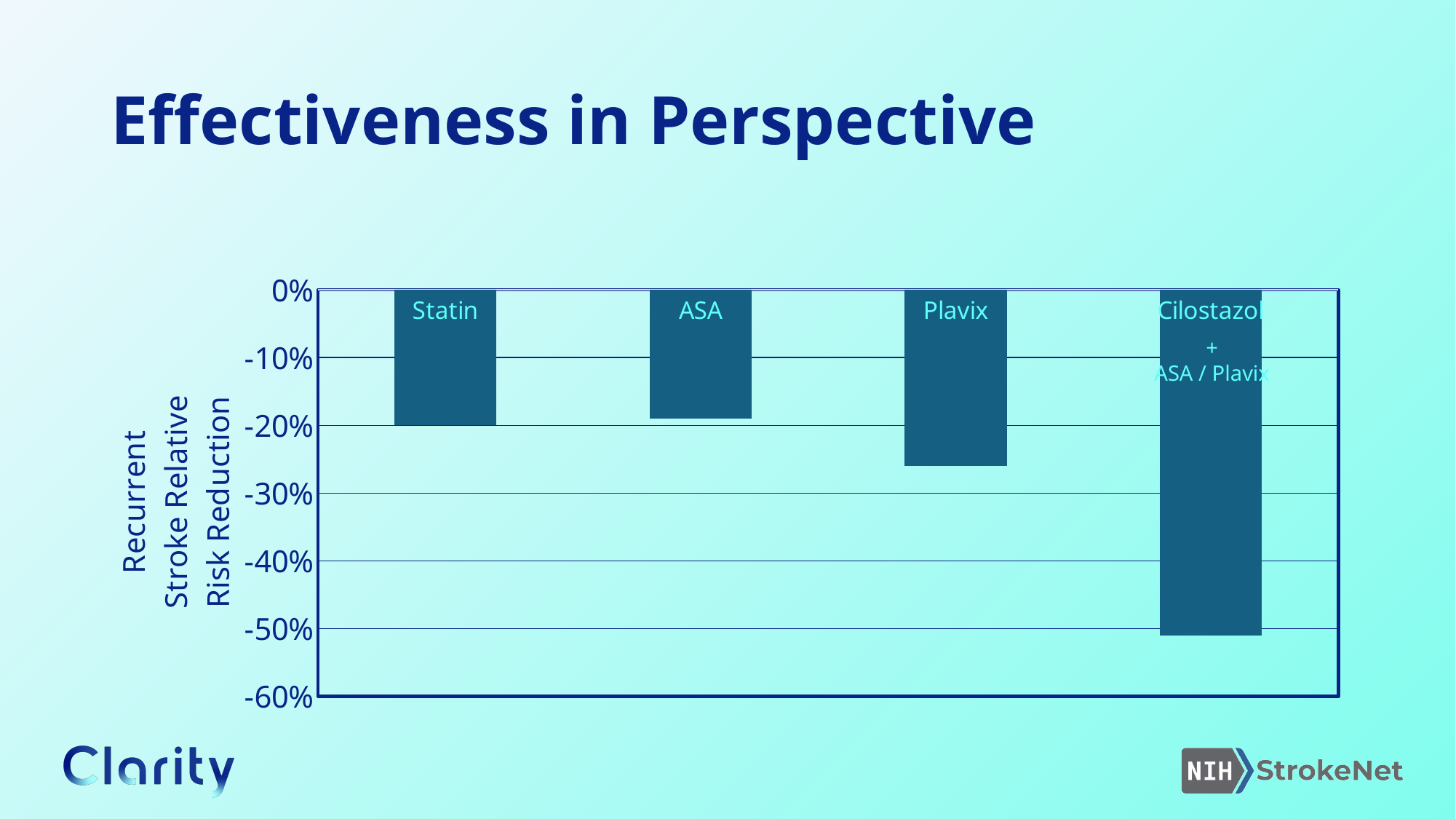
What type of chart is shown on the slide? bar chart Which has the lower value, Cilostazol + ASA / Plavix or ASA? Cilostazol + ASA / Plavix Is the value for ASA greater or less than -30%? greater Which category has the lowest value (largest risk reduction) in the chart? Cilostazol + ASA / Plavix Is the value for Plavix greater or less than -20%? less Which has the lower value, Plavix or Statin? Plavix What is the title of the slide containing the chart? Effectiveness in Perspective What is the value for Statin in the chart? -20% How many categories (bars) are plotted in the chart? 4 What is the label on the vertical axis of the chart? Recurrent Stroke Relative Risk Reduction Is the value for Plavix greater or less than -30%? greater